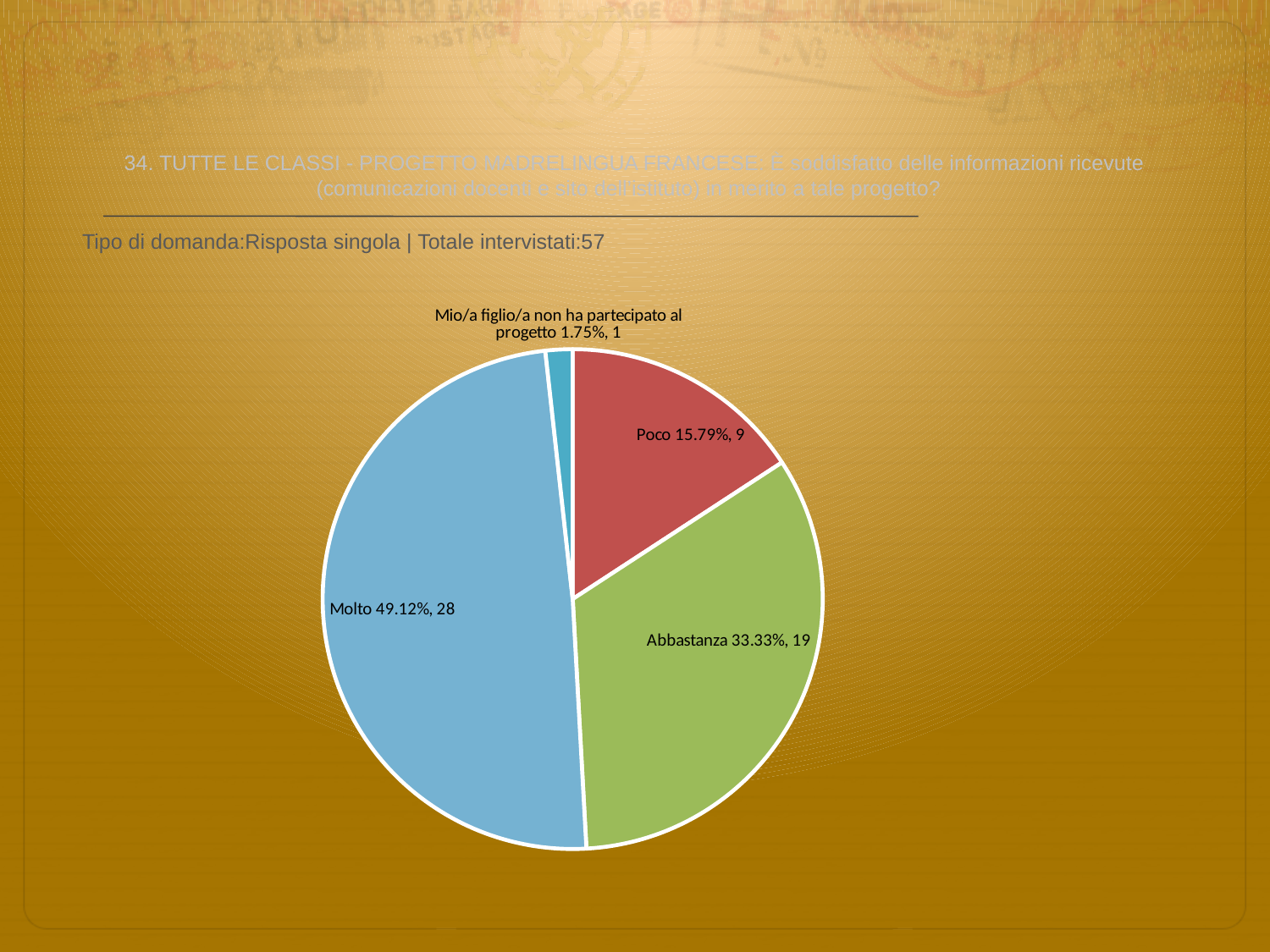
What percentage share does the 'Mio/a figlio/a non ha partecipato al progetto' slice have? 1.75% What percentage share does the 'Molto' slice have? 49.12% Which category has the smallest slice? Mio/a figlio/a non ha partecipato al progetto What kind of chart is shown on the slide? pie chart How many respondents answered 'Poco'? 9 How many slices does the pie chart have? 4 Which category has the largest slice? Molto Which has more respondents, 'Poco' or 'Abbastanza'? Abbastanza What is the total number of respondents shown on the slide? 57 How many respondents answered 'Abbastanza'? 19 What colour is the 'Molto' slice? blue What is the difference in respondent count between 'Molto' and 'Abbastanza'? 9